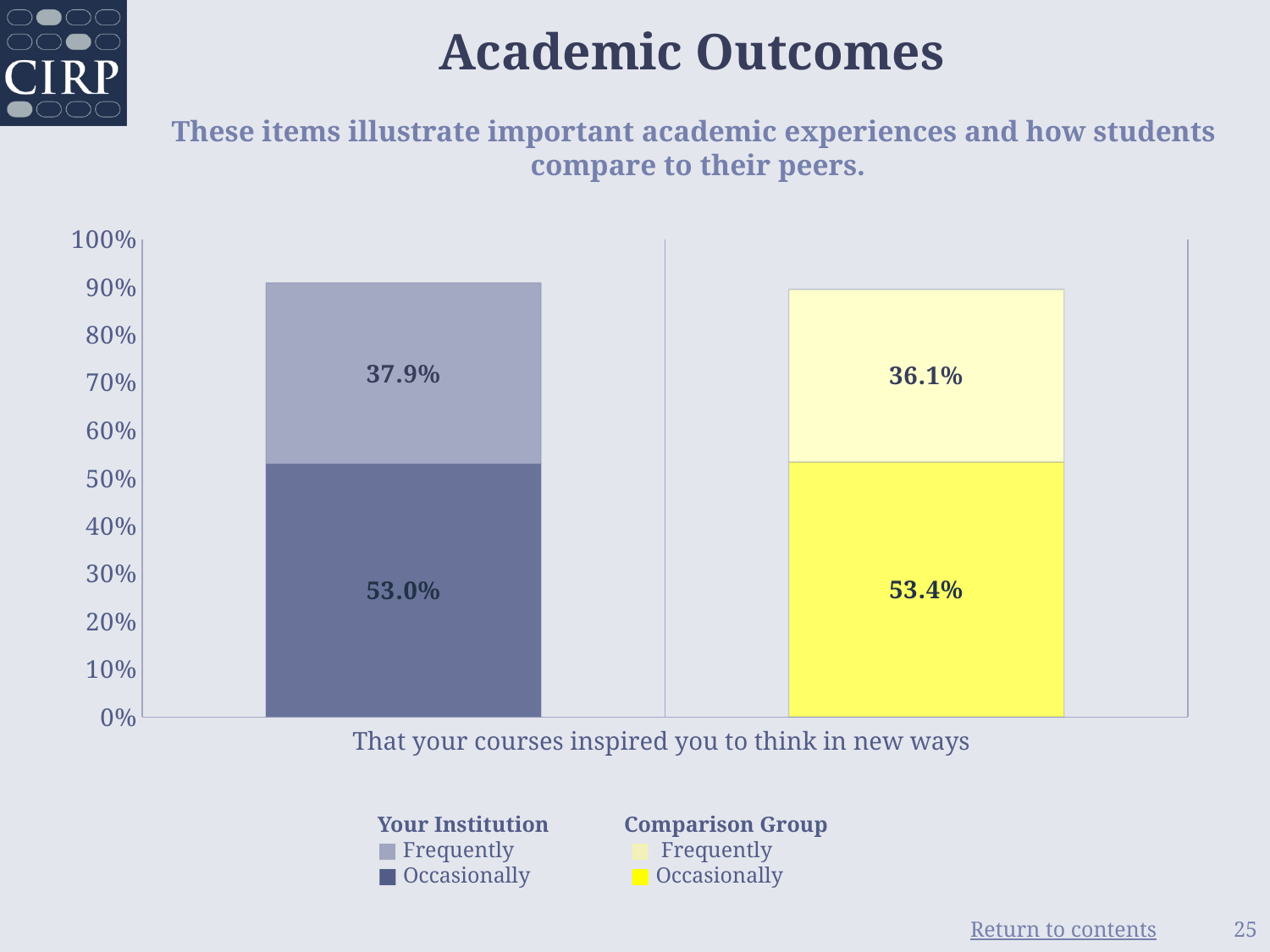
What type of chart is shown on the slide? Stacked bar chart What percentage of the Comparison Group reported 'Occasionally' for 'That your courses inspired you to think in new ways'? 53.4% How many bars are plotted in the chart? 2 What percentage of the Comparison Group reported 'Frequently' for 'That your courses inspired you to think in new ways'? 36.1% What percentage of students at Your Institution reported 'Frequently' for 'That your courses inspired you to think in new ways'? 37.9% What is the combined total of 'Frequently' and 'Occasionally' for Your Institution? 90.9% What percentage of students at Your Institution reported 'Occasionally' for 'That your courses inspired you to think in new ways'? 53.0% What is the combined total of 'Frequently' and 'Occasionally' for the Comparison Group? 89.5% What is the difference between the 'Occasionally' values for the Comparison Group and Your Institution? 0.4% What is the title of the slide containing the chart? Academic Outcomes What is the difference between the 'Frequently' values for Your Institution and the Comparison Group? 1.8% Which group has the higher 'Frequently' value, Your Institution or the Comparison Group? Your Institution